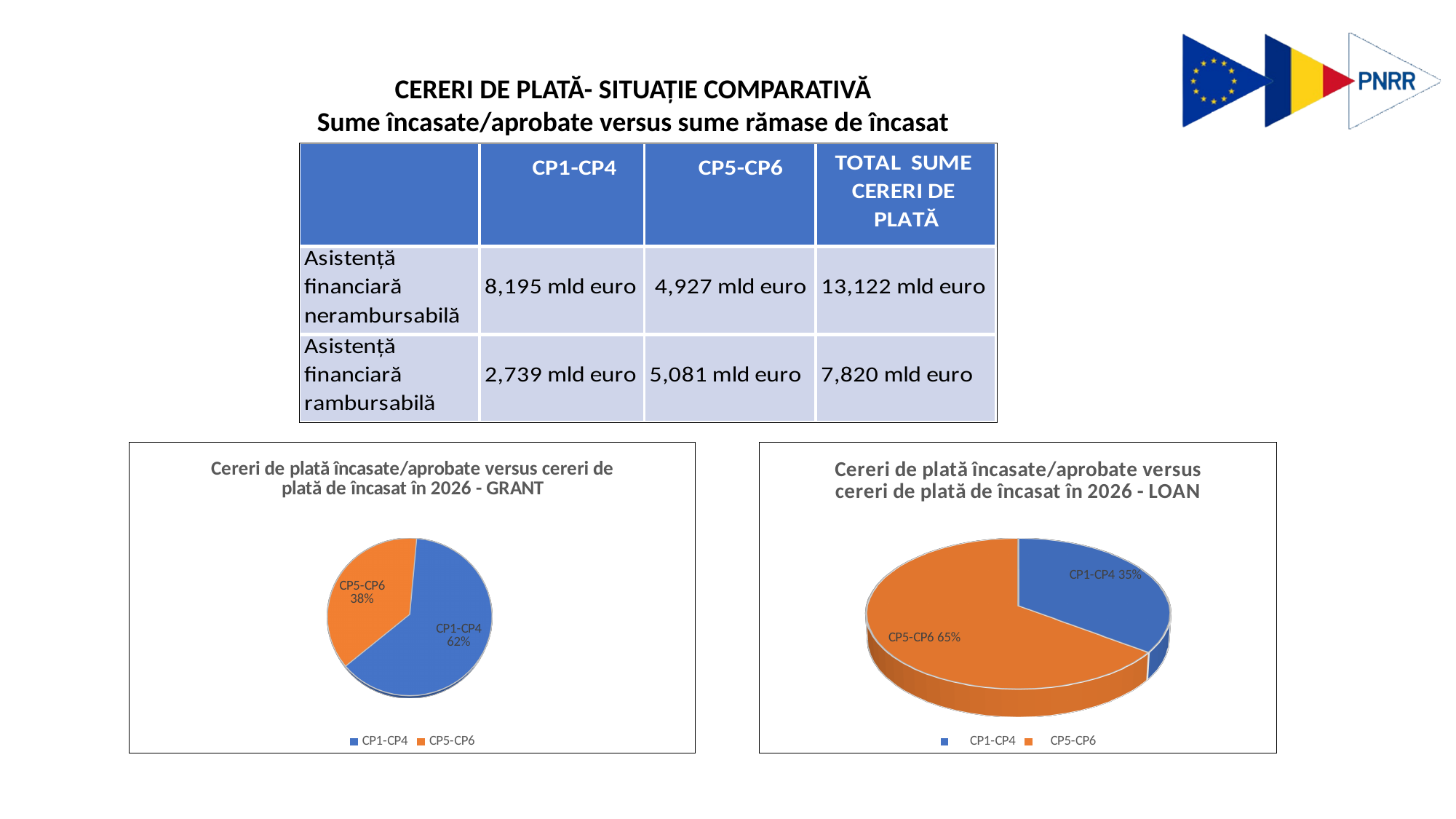
In the GRANT pie chart, what is the difference in percentage points between the CP1-CP4 and CP5-CP6 shares? 24 In the LOAN pie chart, which is larger, CP1-CP4 or CP5-CP6? CP5-CP6 In the LOAN pie chart, what share does CP1-CP4 have? 35% How many entries does the legend of the GRANT pie chart list? 2 In the GRANT pie chart, which slice is the largest? CP1-CP4 In the GRANT pie chart, what share does CP1-CP4 have? 62% In the LOAN pie chart, what share does CP5-CP6 have? 65% In the LOAN pie chart, what is the difference in percentage points between the CP5-CP6 and CP1-CP4 shares? 30 How many slices does the GRANT pie chart have? 2 In the GRANT pie chart, what share does CP5-CP6 have? 38% What type of chart is the LOAN chart on the right? Pie chart In the LOAN pie chart, which slice is the smallest? CP1-CP4